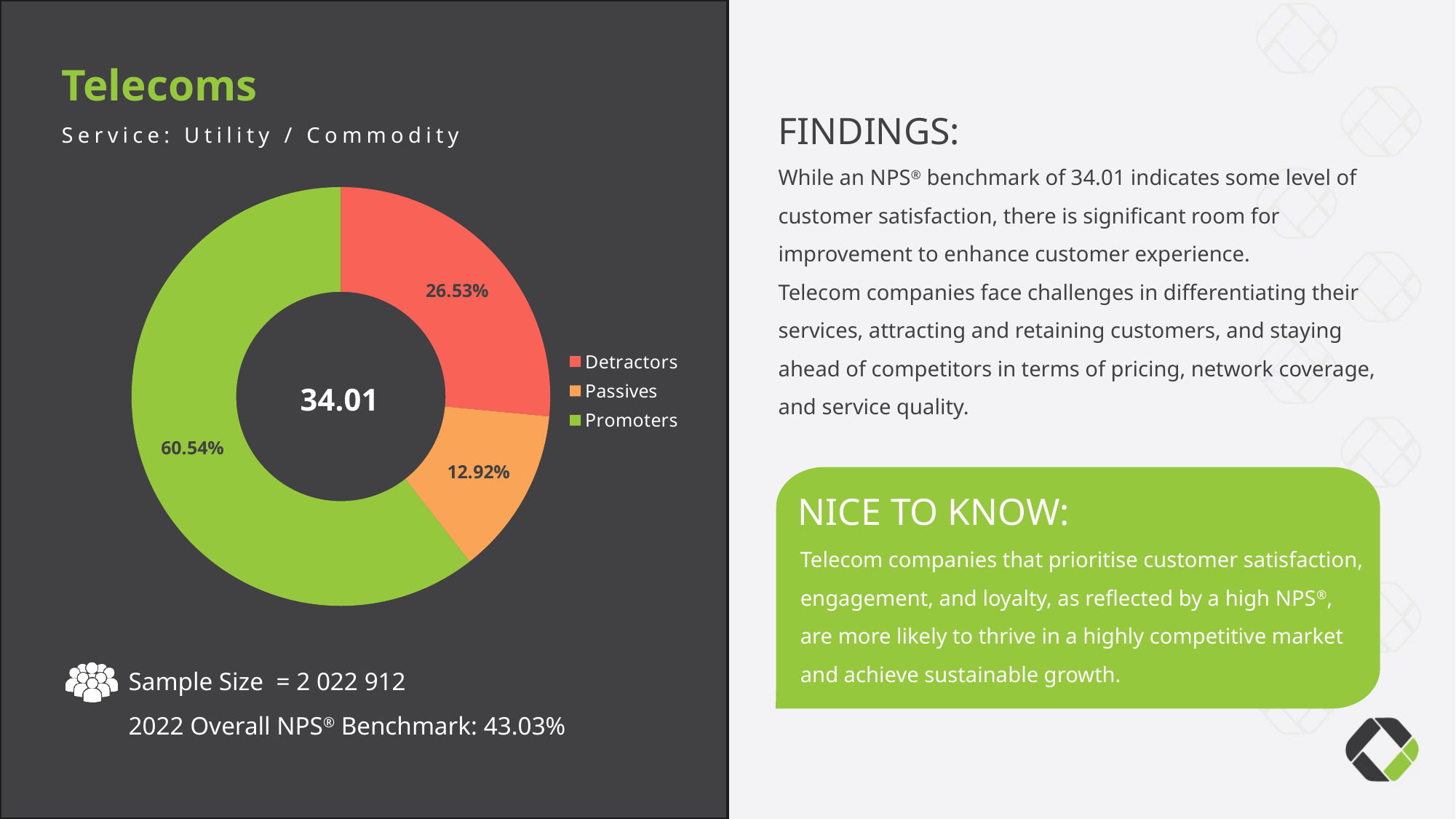
Which is larger, the Detractors share or the Passives share? Detractors Which category has the smallest share of the donut chart? Passives Which colour represents Passives in the chart legend? Orange Which category has the largest share of the donut chart? Promoters What is the difference in percentage points between Promoters and Detractors? 34.01 What percentage of the donut chart is Promoters? 60.54% What is the difference in percentage points between Detractors and Passives? 13.61 How many categories does the donut chart show? 3 What percentage of the donut chart is Detractors? 26.53% What number is displayed in the centre of the donut chart? 34.01 What kind of chart is shown on the slide? Donut (pie) chart What percentage of the donut chart is Passives? 12.92%